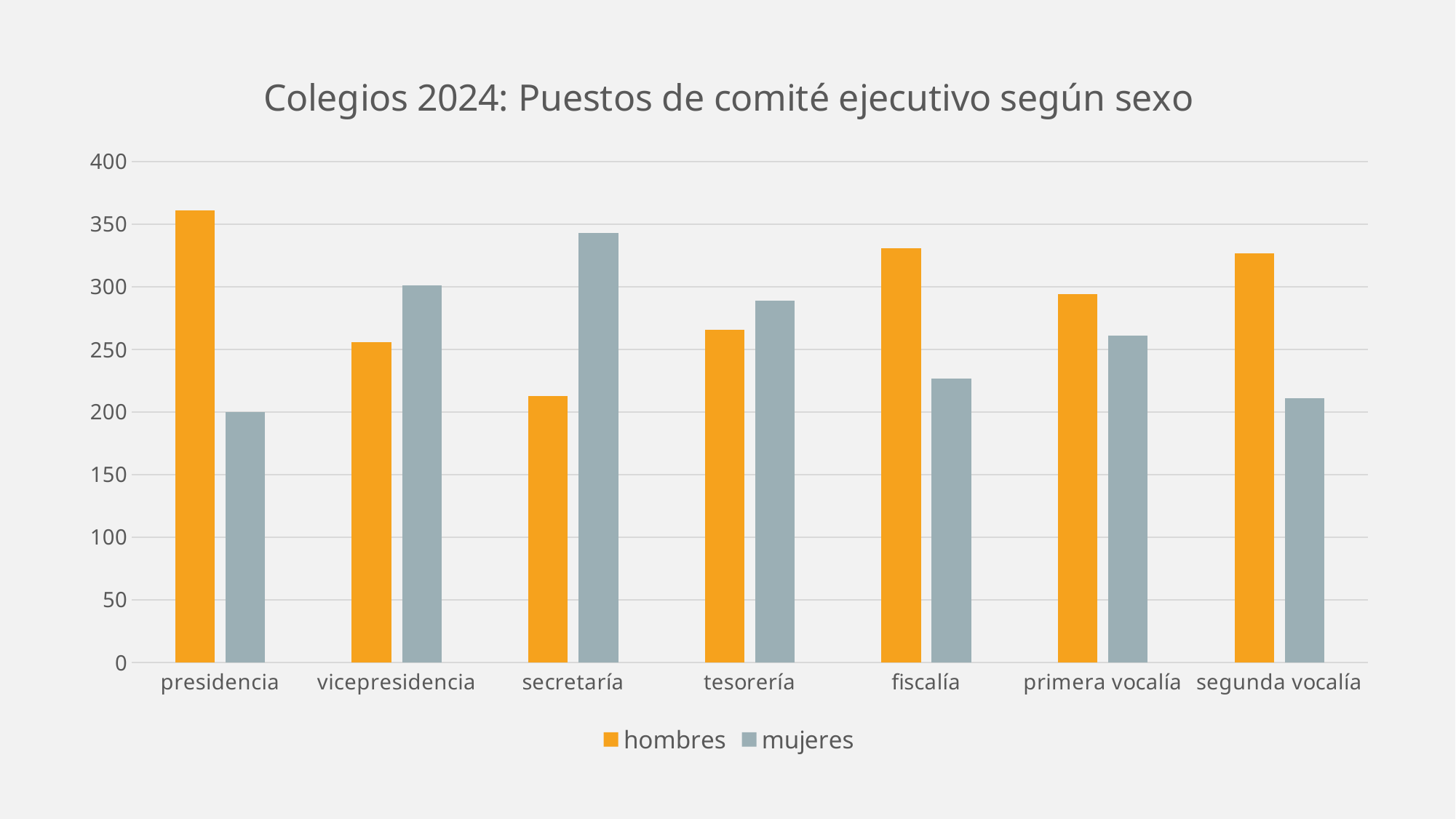
Is the value for hombres in presidencia greater or less than 350? greater In fiscalía, which is larger, hombres or mujeres? hombres Which category has the lowest value for hombres? secretaría How many series does the legend list? 2 In vicepresidencia, which is larger, hombres or mujeres? mujeres Which category has the highest value for hombres? presidencia Which category has the highest value for mujeres? secretaría Is the value for mujeres in fiscalía greater or less than 250? less Is the value for mujeres in secretaría greater or less than 300? greater What is the title of the chart? Colegios 2024: Puestos de comité ejecutivo según sexo What kind of chart is shown on the slide? bar chart How many categories are shown on the x axis? 7